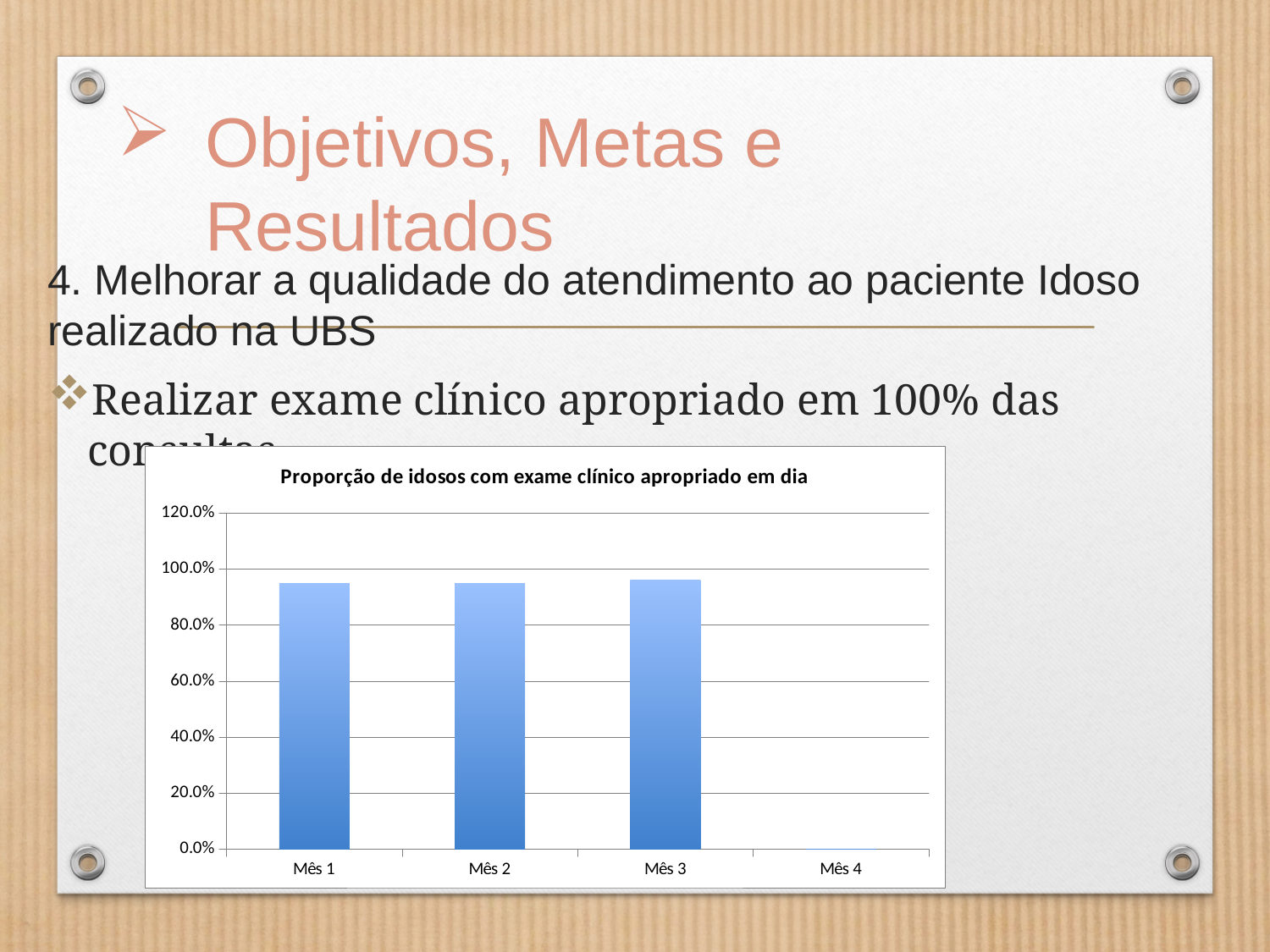
Is the value for Mês 3 greater or less than 80.0%? greater What is the highest value shown on the y axis of the chart? 120.0% What is the title of the chart? Proporção de idosos com exame clínico apropriado em dia Is the value for Mês 3 greater or less than 100.0%? less Which category on the x axis has no bar plotted? Mês 4 What kind of chart is shown on the slide? bar chart Is the value for Mês 1 greater or less than 80.0%? greater How many categories are shown on the x axis of the chart? 4